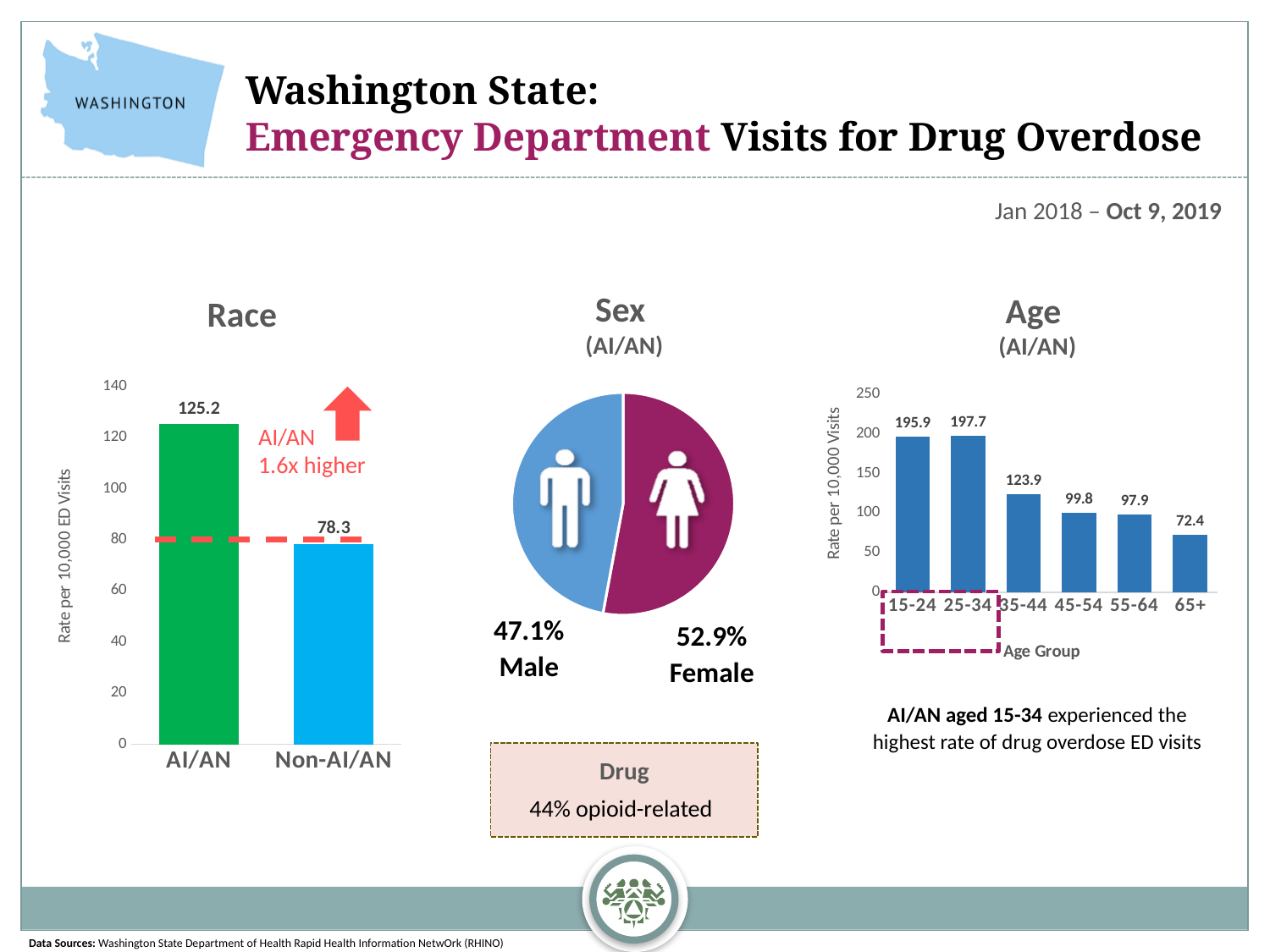
In the Sex (AI/AN) pie chart, what share of visits is Male? 47.1% In the Sex (AI/AN) pie chart, what share of visits is Female? 52.9% In the Race chart, which group has the higher rate, AI/AN or Non-AI/AN? AI/AN How many age groups are shown in the Age (AI/AN) chart? 6 In the Race chart, what is the rate per 10,000 ED visits for AI/AN? 125.2 In the Age (AI/AN) chart, what is the difference between the rates for 45-54 and 55-64? 1.9 What kind of chart is the Race chart? Bar chart In the Race chart, what is the difference between the AI/AN and Non-AI/AN rates? 46.9 In the Age (AI/AN) chart, which age group has the lowest rate? 65+ In the Age (AI/AN) chart, what is the rate for the 35-44 age group? 123.9 In the Race chart, what is the rate per 10,000 ED visits for Non-AI/AN? 78.3 In the Age (AI/AN) chart, which age group has the highest rate? 25-34